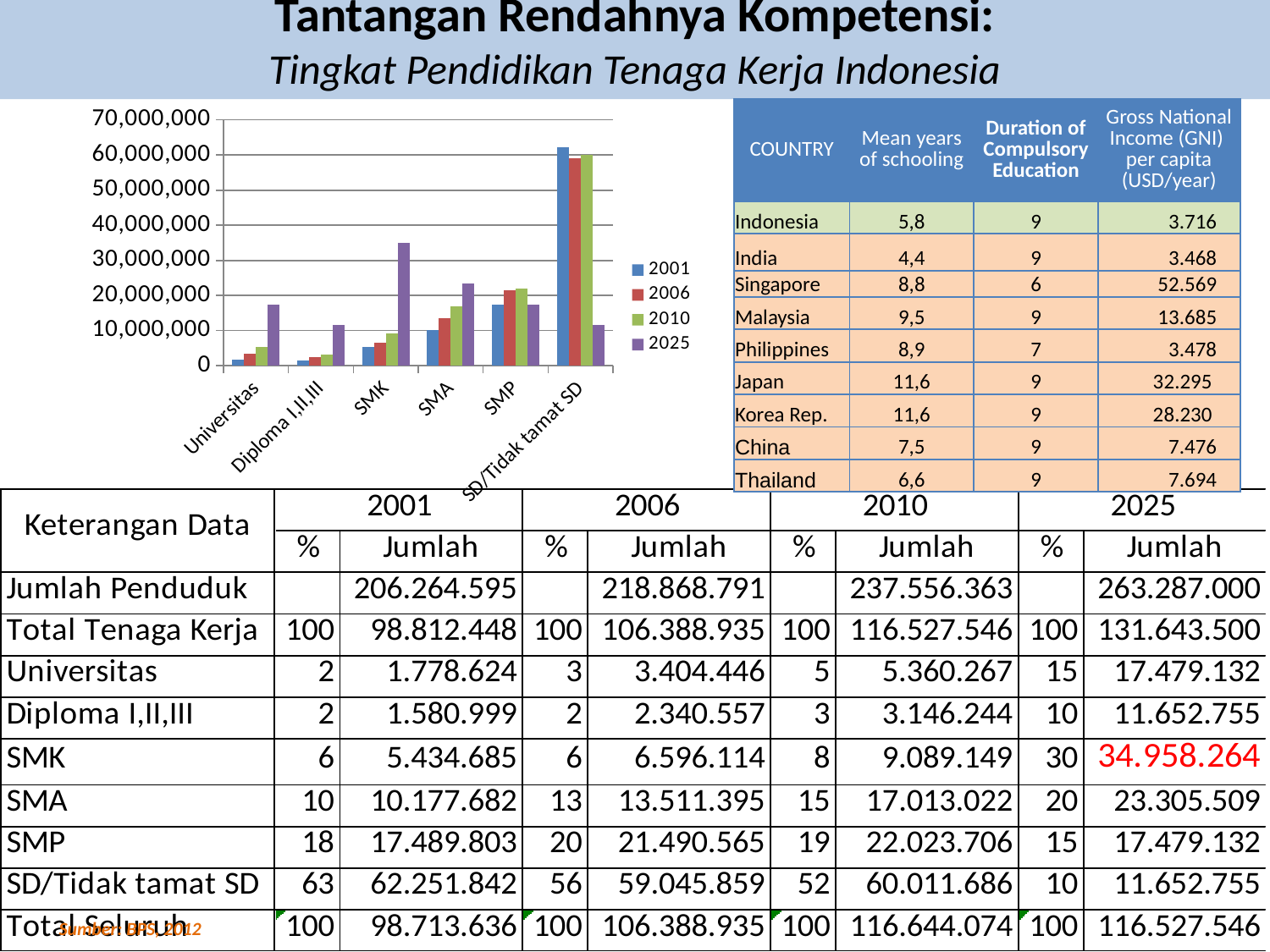
In the bar chart, which is larger for the 2025 series: SMK or SMA? SMK In the bar chart, is the 2001 value for Universitas greater or less than 10,000,000? less In the bar chart, which is larger for SD/Tidak tamat SD: the 2001 value or the 2025 value? 2001 How many series does the legend of the bar chart list? 4 In the bar chart, is the 2025 value for SMA greater or less than 20,000,000? greater In the bar chart, which category has the tallest bar for the 2025 series? SMK In the bar chart, is the 2001 value for SD/Tidak tamat SD greater or less than 50,000,000? greater How many education-level categories are shown on the x axis of the bar chart? 6 What kind of chart is shown on the left of the slide? bar chart In the bar chart, which category has the highest value for the 2001 series? SD/Tidak tamat SD Which years are listed in the legend of the bar chart? 2001, 2006, 2010, 2025